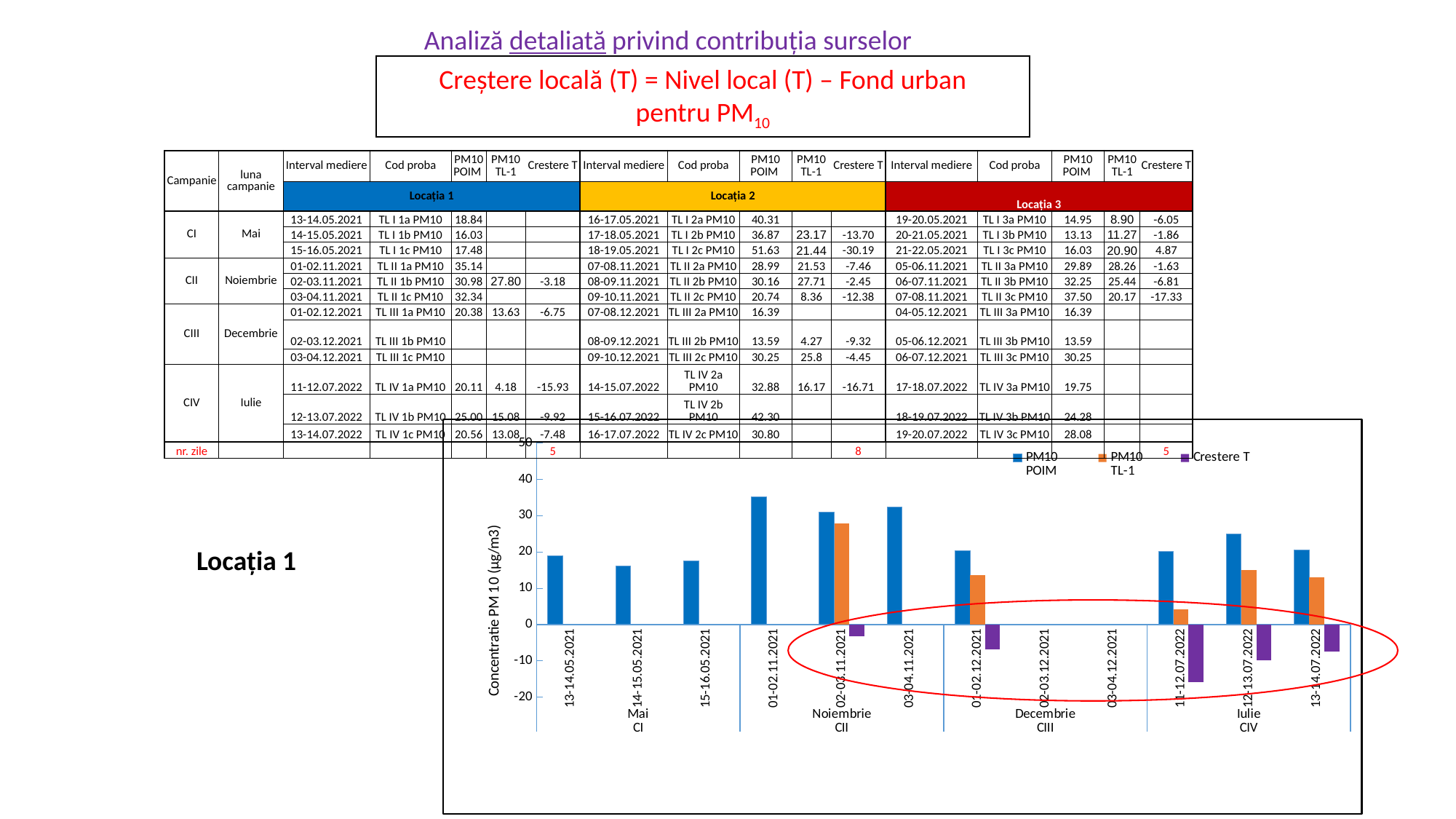
How many date categories are shown along the x axis of the chart? 12 What kind of chart is shown on the slide? bar chart How many series does the chart legend list? 3 On 02-03.11.2021, which is larger in the chart: PM10 POIM or PM10 TL-1? PM10 POIM What is the title of the chart's vertical axis? Concentratie PM 10 (µg/m3) Which date has the highest PM10 TL-1 bar in the chart? 02-03.11.2021 Is the PM10 POIM value for 01-02.11.2021 greater or less than 30? greater Is the PM10 TL-1 value for 11-12.07.2022 greater or less than 10? less Is the PM10 POIM value for 13-14.05.2021 greater or less than 20? less Which date has the lowest Crestere T bar in the chart? 11-12.07.2022 Which date has the highest PM10 POIM bar in the chart? 01-02.11.2021